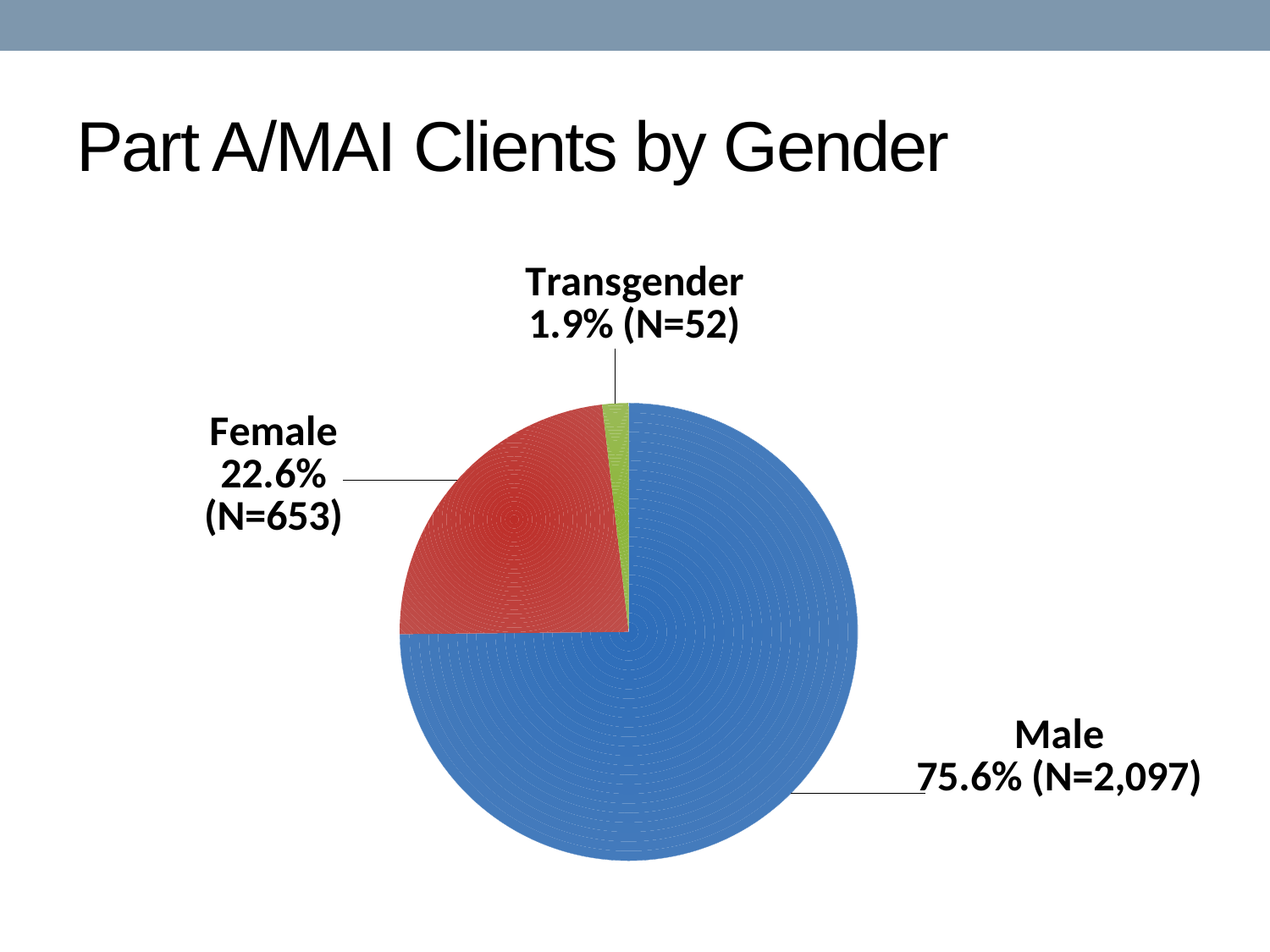
How many Female clients are shown (N)? 653 How many Male clients are shown (N)? 2,097 How many Transgender clients are shown (N)? 52 What percentage of Part A/MAI clients are Male? 75.6% What is the title of the slide? Part A/MAI Clients by Gender Which gender category has the smallest share of clients? Transgender Which gender category has the largest share of clients? Male What percentage of Part A/MAI clients are Female? 22.6% What percentage of Part A/MAI clients are Transgender? 1.9% How many categories does the pie chart show? 3 What kind of chart is shown on the slide? pie chart What is the difference in percentage points between the Male and Female shares? 53.0%